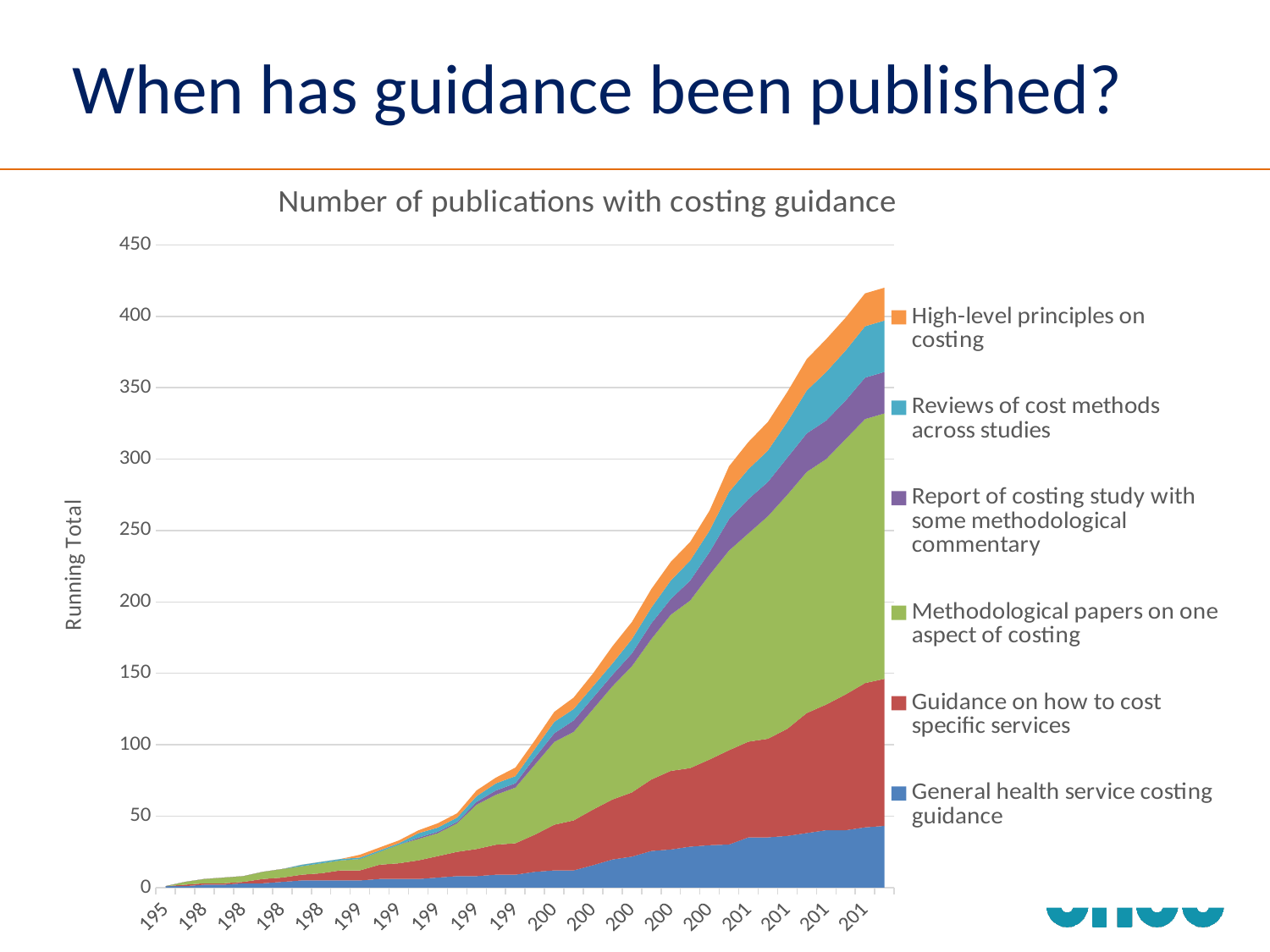
Is the total running total at the right end of the chart greater or less than 450? less What is the title of the chart? Number of publications with costing guidance Is the total running total at the right end of the chart greater or less than 400? greater Which series contributes the largest share of the running total at the right end of the chart? Methodological papers on one aspect of costing Is the value for General health service costing guidance at the right end of the chart greater or less than 100? less What kind of chart is shown on the slide? Stacked area chart What is the label on the vertical axis? Running Total Does the running total rise or fall over time along the x axis? Rises Which is larger at the right end of the chart: Methodological papers on one aspect of costing or Guidance on how to cost specific services? Methodological papers on one aspect of costing How many series does the legend list? 6